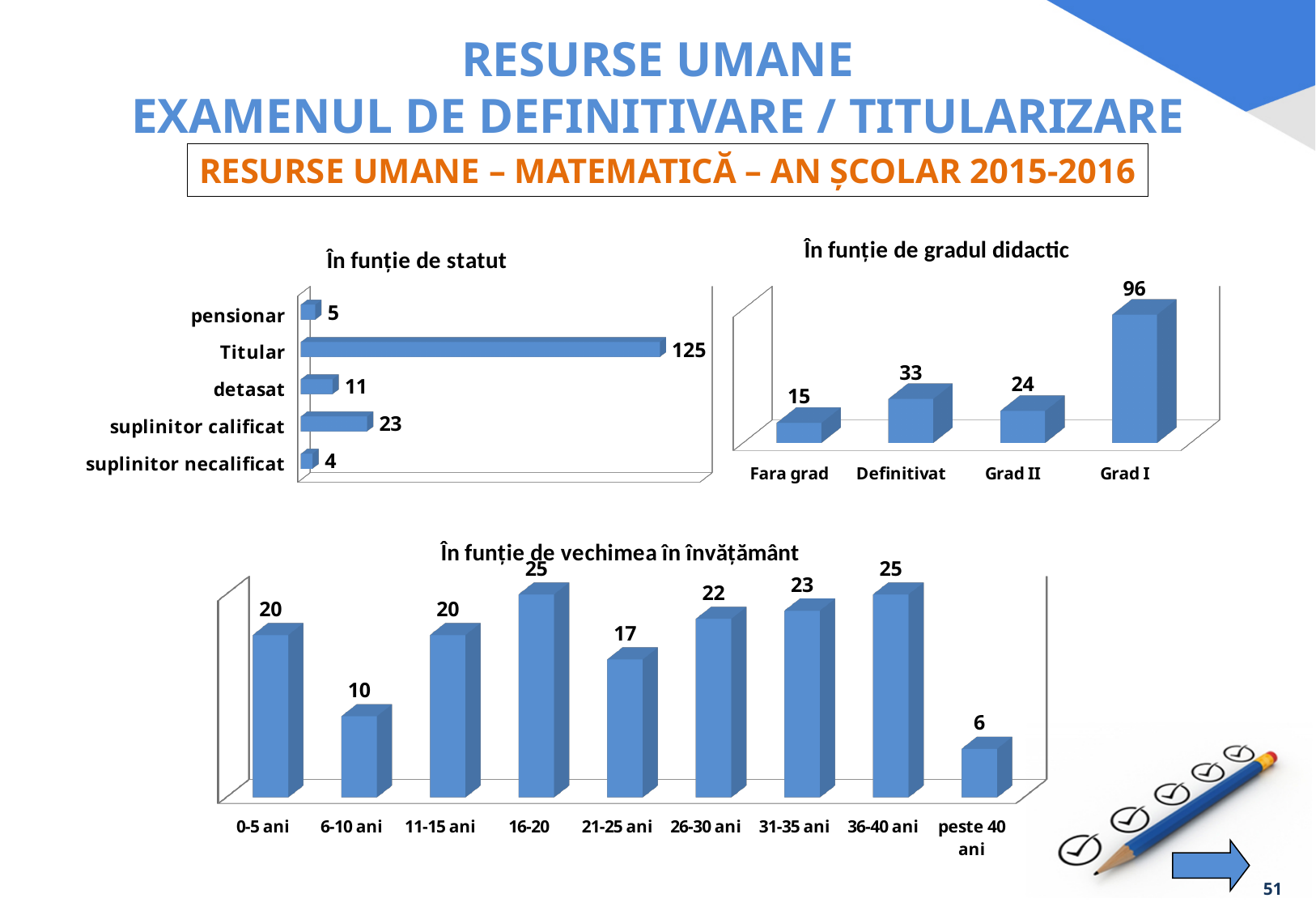
What kind of chart is the one titled 'În funție de statut'? bar chart In the chart titled 'În funție de vechimea în învățământ', what is the value for 21-25 ani? 17 In the chart titled 'În funție de gradul didactic', what is the value for Definitivat? 33 In the chart titled 'În funție de gradul didactic', which category has the highest value? Grad I In the chart titled 'În funție de gradul didactic', what is the difference between Grad I and Definitivat? 63 In the chart titled 'În funție de vechimea în învățământ', how many categories are shown on the x axis? 9 In the chart titled 'În funție de statut', what is the difference between the values for suplinitor calificat and detasat? 12 In the chart titled 'În funție de statut', which category has the lowest value? suplinitor necalificat In the chart titled 'În funție de statut', what is the value for Titular? 125 In the chart titled 'În funție de vechimea în învățământ', which category has the lowest value? peste 40 ani In the chart titled 'În funție de gradul didactic', which is larger, Grad II or Fara grad? Grad II In the chart titled 'În funție de statut', how many categories are shown? 5